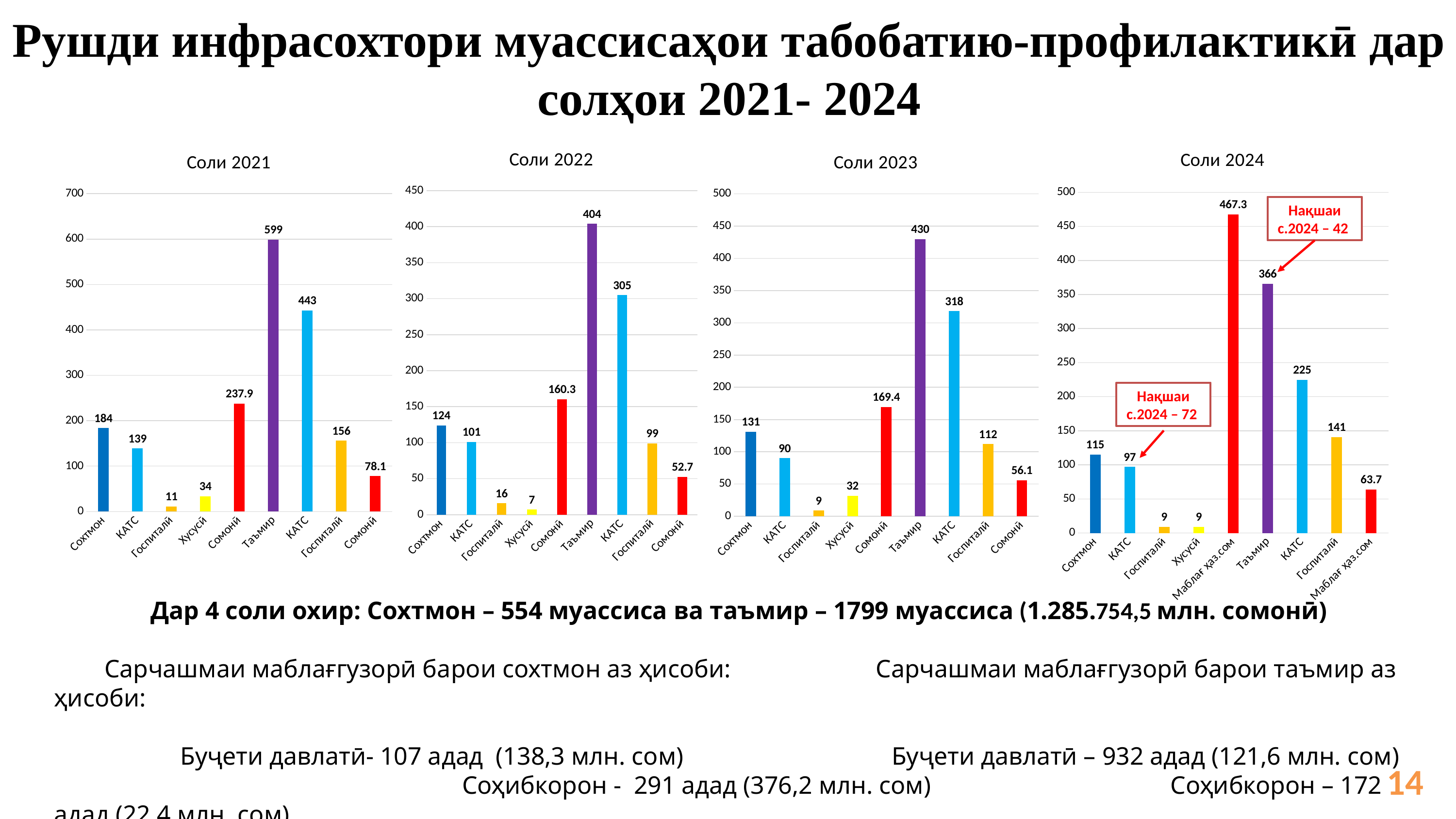
How many charts are shown on the slide? 4 What kind of chart is the Соли 2021 chart? Bar chart In the Соли 2024 chart, what is the value for Таъмир? 366 In the Соли 2021 chart, which category has the lowest bar? Госпиталӣ In the Соли 2022 chart, which is larger: Таъмир or Сохтмон? Таъмир In the Соли 2023 chart, what is the difference between the values for Таъмир and Сохтмон? 299 In the Соли 2022 chart, what is the value for Сохтмон? 124 In the Соли 2021 chart, what is the value for Таъмир? 599 How many bars are plotted in the Соли 2024 chart? 9 In the Соли 2023 chart, what is the value for Хусусӣ? 32 In the Соли 2024 chart, what is the difference between the values for Таъмир and Сохтмон? 251 In the Соли 2024 chart, which category has the highest bar? Маблағ ҳаз.сом